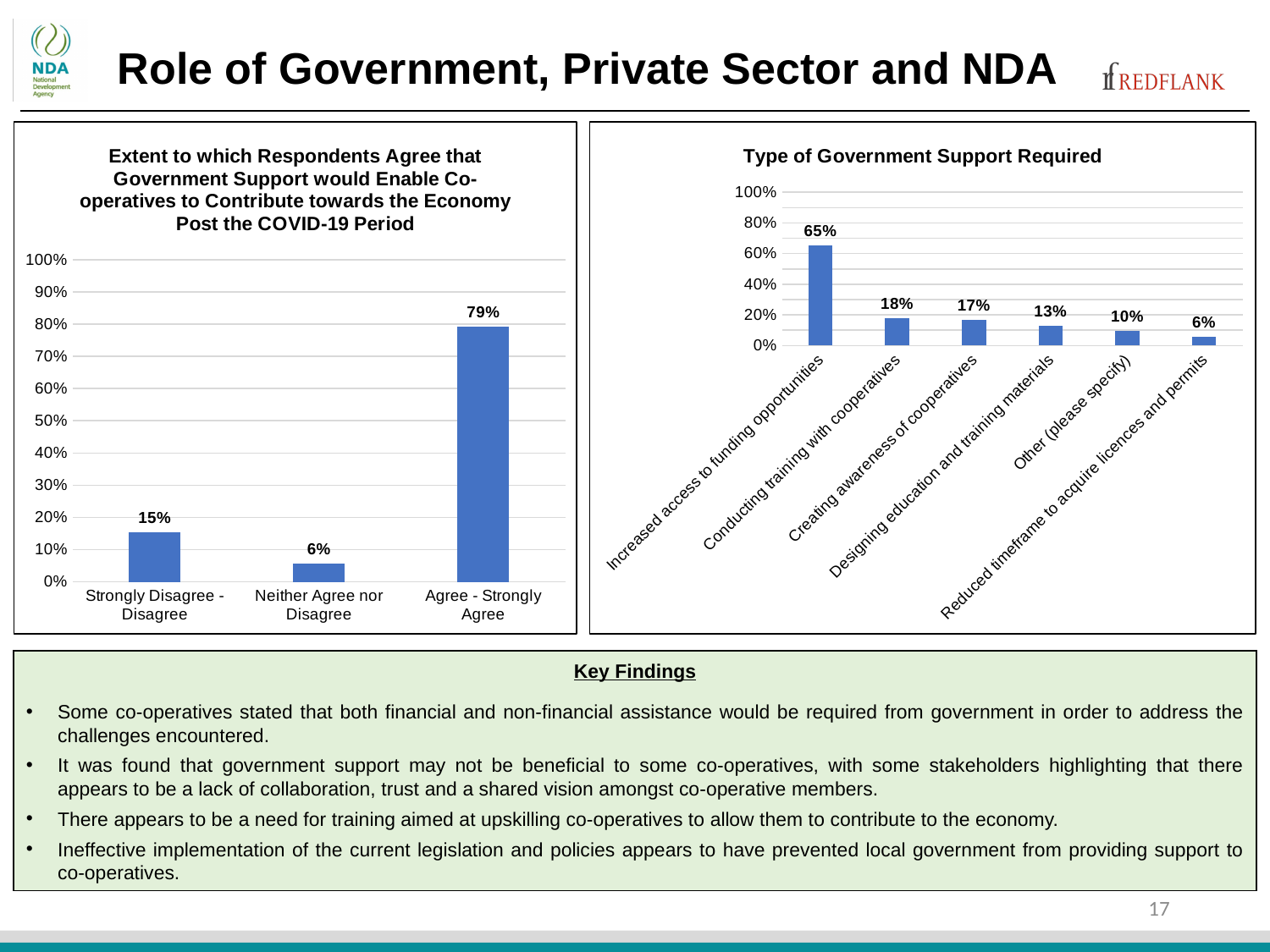
In the right chart (Type of Government Support Required), which category has the highest value? Increased access to funding opportunities In the right chart (Type of Government Support Required), which category has the lowest value? Reduced timeframe to acquire licences and permits In the right chart (Type of Government Support Required), which is larger: Conducting training with cooperatives or Other (please specify)? Conducting training with cooperatives What kind of chart is the right chart (Type of Government Support Required)? Bar chart In the right chart (Type of Government Support Required), how many categories are shown? 6 In the right chart (Type of Government Support Required), what is the value for Increased access to funding opportunities? 65% In the right chart (Type of Government Support Required), what is the value for Designing education and training materials? 13% In the left chart (Extent to which Respondents Agree that Government Support would Enable Co-operatives to Contribute towards the Economy Post the COVID-19 Period), what is the value for Agree - Strongly Agree? 79% In the left chart (Extent to which Respondents Agree...), which category has the lowest value? Neither Agree nor Disagree In the left chart (Extent to which Respondents Agree...), what is the difference between Agree - Strongly Agree and Strongly Disagree - Disagree? 64% In the left chart (Extent to which Respondents Agree...), what is the value for Neither Agree nor Disagree? 6% In the left chart (Extent to which Respondents Agree...), how many categories are shown? 3